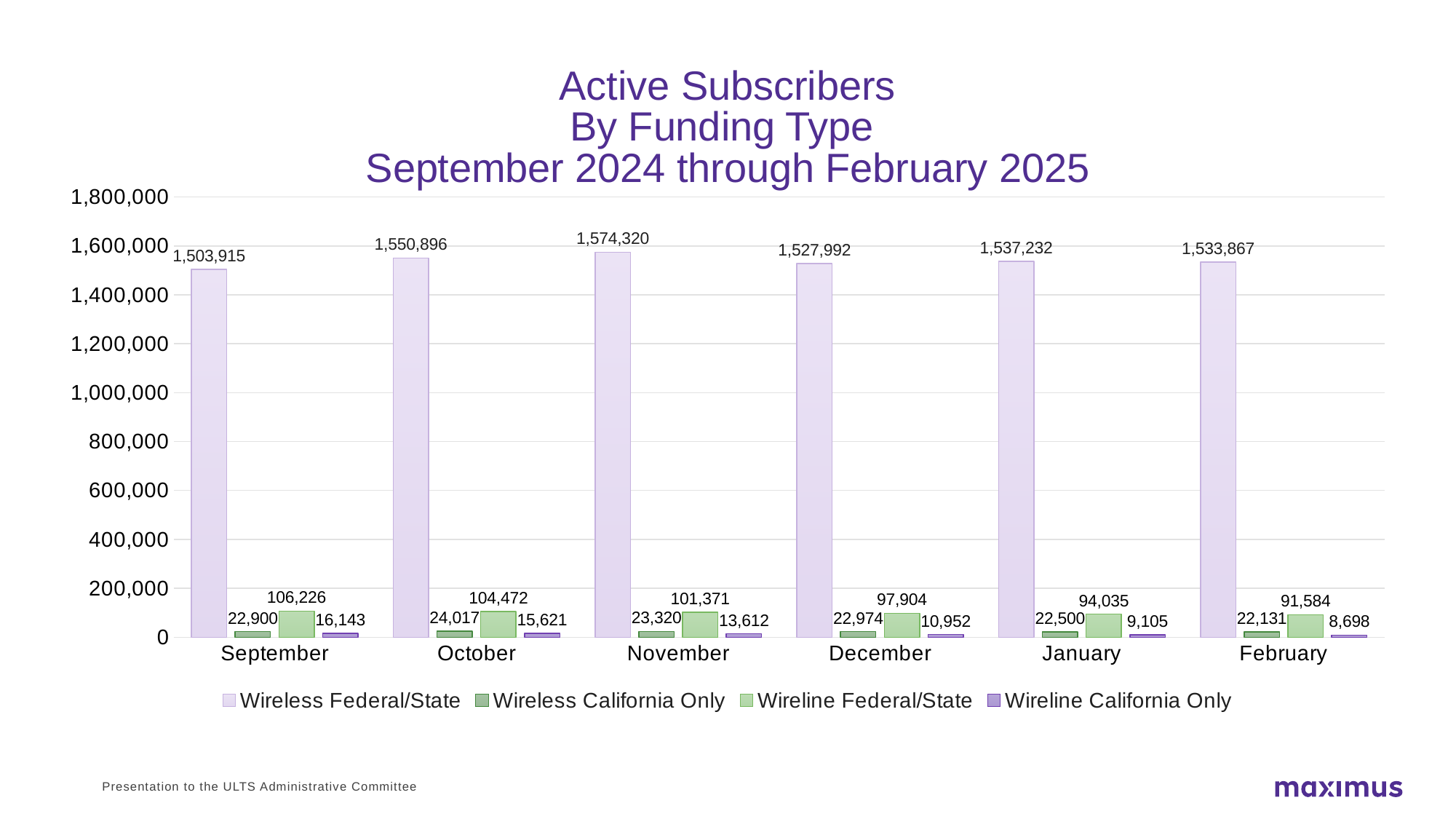
How many series does the legend list? 4 What kind of chart is shown on the slide? Bar chart What is the value for Wireless Federal/State in November? 1,574,320 What is the value for Wireless California Only in October? 24,017 In which month is Wireline California Only lowest? February What is the difference between Wireless Federal/State in November and in September? 70,405 How many months are shown on the x axis? 6 What is the value for Wireline California Only in February? 8,698 What is the value for Wireline Federal/State in December? 97,904 Does Wireline Federal/State rise or fall from September to February? Fall Which is larger, Wireline Federal/State in September or in January? September In which month is Wireless Federal/State highest? November